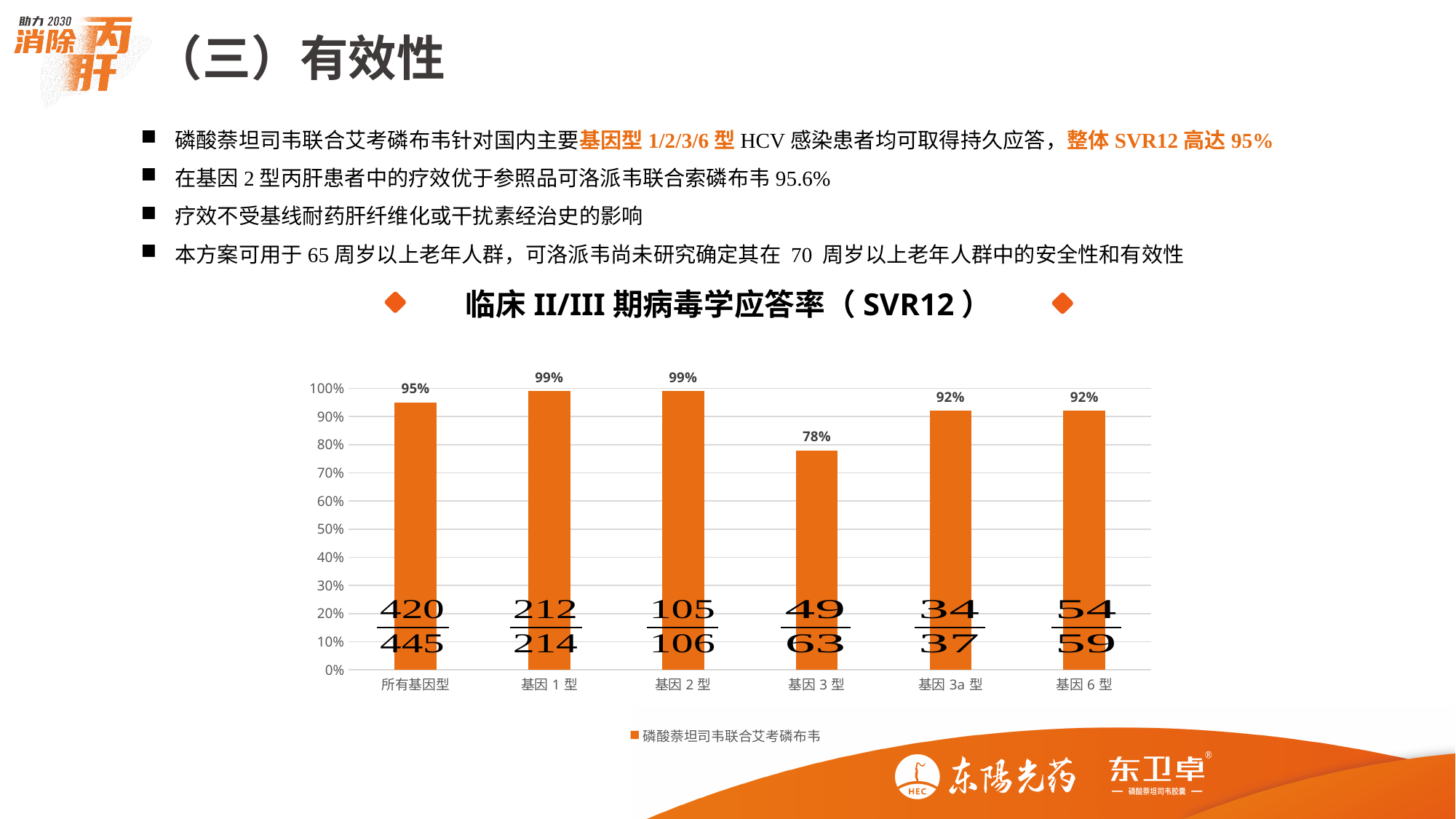
What is the title of the chart? 临床 II/III 期病毒学应答率（SVR12） How many categories are shown on the x axis? 6 What is the SVR12 value for 基因 3 型? 78% Is the value for 基因 3 型 greater or less than 80%? less What is the difference between the SVR12 values for 基因 1 型 and 基因 3 型? 21% Which category has the lowest SVR12 value? 基因 3 型 What is the SVR12 value for 所有基因型? 95% What kind of chart is shown? bar chart What is the legend entry for the series? 磷酸萘坦司韦联合艾考磷布韦 How many series does the legend list? 1 Which is larger, the SVR12 value for 基因 3a 型 or for 基因 3 型? 基因 3a 型 What is the SVR12 value for 基因 6 型? 92%